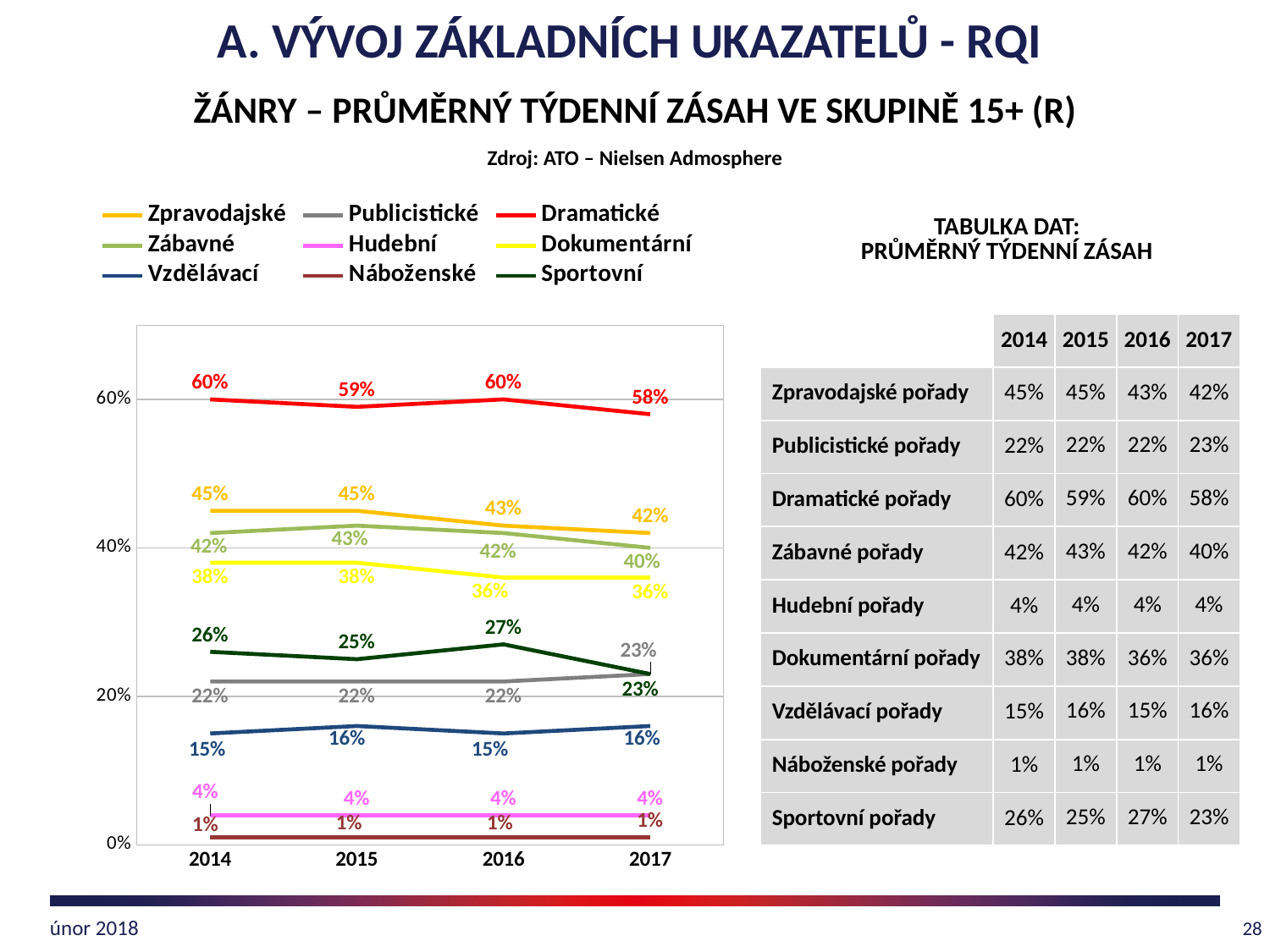
Which is larger in 2016, Zábavné or Dokumentární? Zábavné What is the difference between the Dramatické value in 2016 and in 2017? 2% What is the value for Zpravodajské in 2017? 42% What kind of chart is shown? Line chart Which series has the lowest value in 2017? Náboženské What is the value for Sportovní in 2015? 25% Which series has the highest value in 2014? Dramatické Which is larger in 2017, Publicistické or Sportovní? They are equal (23%) Does the Zpravodajské series rise or fall from 2015 to 2017? Fall How many series does the legend list? 9 What is the value for Dramatické in 2016? 60% How many years are shown on the x axis? 4